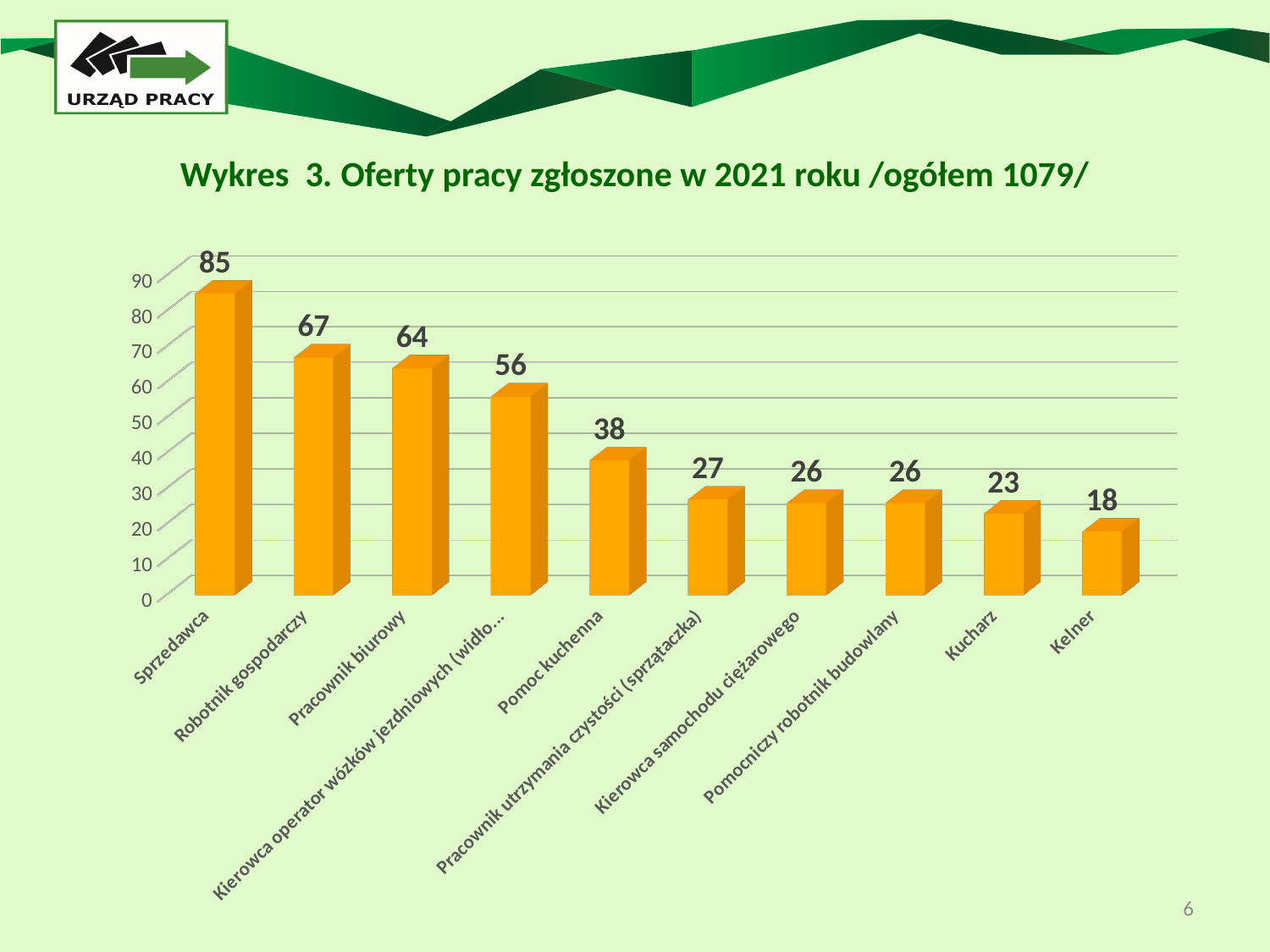
What is the value for Sprzedawca? 85 What is the value for Kucharz? 23 What is the title of the chart? Wykres 3. Oferty pracy zgłoszone w 2021 roku /ogółem 1079/ How many categories are shown on the chart? 10 What is the difference between the values for Sprzedawca and Robotnik gospodarczy? 18 Which category has the lowest value? Kelner Is the value for Kelner greater or less than 20? less Which is larger, the value for Robotnik gospodarczy or the value for Pracownik biurowy? Robotnik gospodarczy What is the difference between the values for Pracownik biurowy and Pomoc kuchenna? 26 Which category has the highest value? Sprzedawca What kind of chart is shown on the slide? bar chart What is the value for Pomoc kuchenna? 38